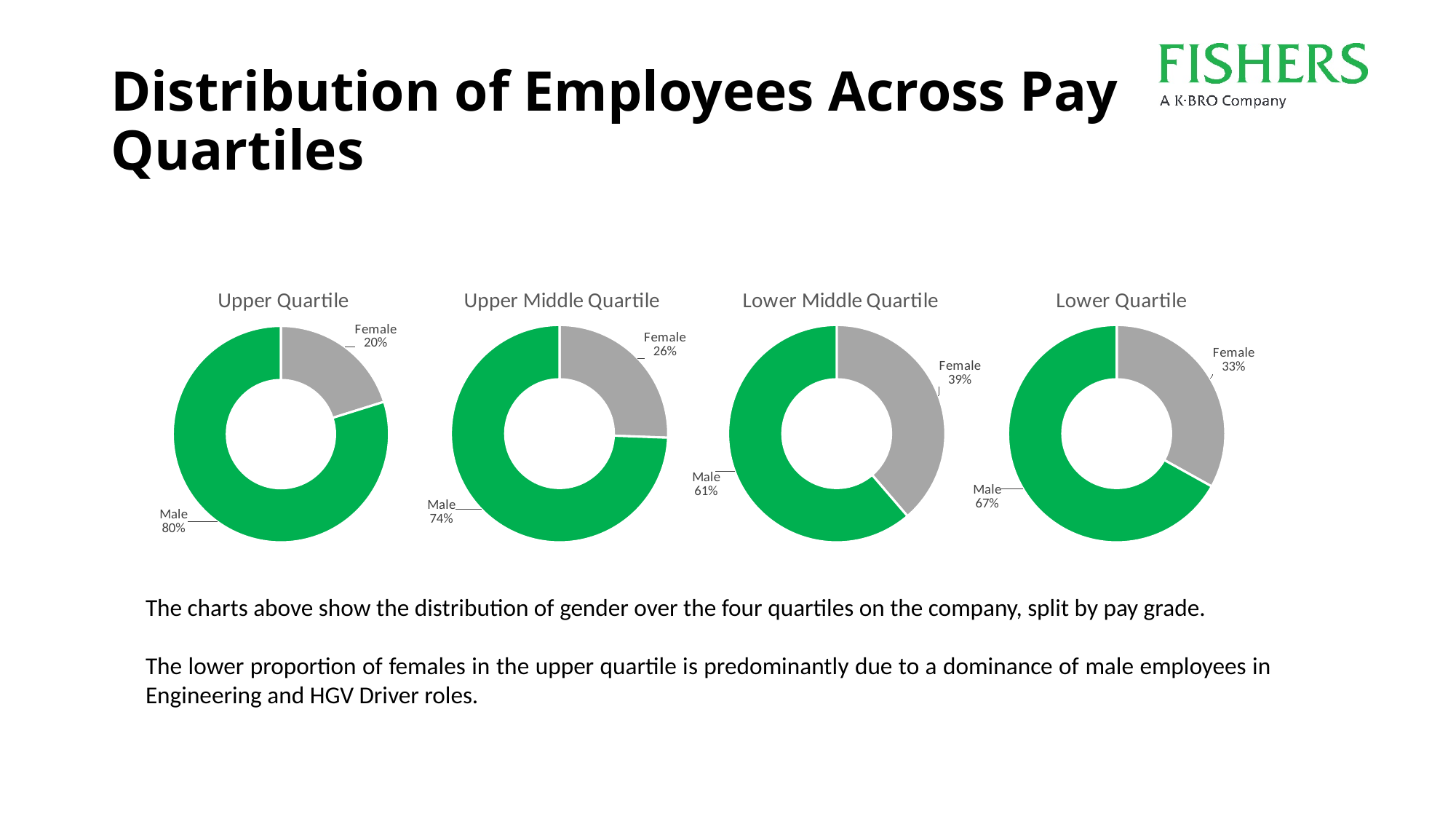
In the Lower Middle Quartile chart, what percentage of employees are female? 39% In the Lower Quartile chart, what percentage of employees are male? 67% How many charts are shown on the slide? 4 In the Lower Middle Quartile chart, what is the difference between the male and female percentages? 22% In the Upper Quartile chart, what is the difference between the male and female percentages? 60% Which of the four charts shows the lowest female percentage? Upper Quartile What kind of chart is the Upper Middle Quartile chart? Doughnut chart In the Upper Quartile chart, what percentage of employees are female? 20% In the Upper Middle Quartile chart, what percentage of employees are male? 74% In the Upper Quartile chart, which category has the larger share, Male or Female? Male Which of the four charts shows the highest female percentage? Lower Middle Quartile How many categories are shown in the Lower Quartile chart? 2